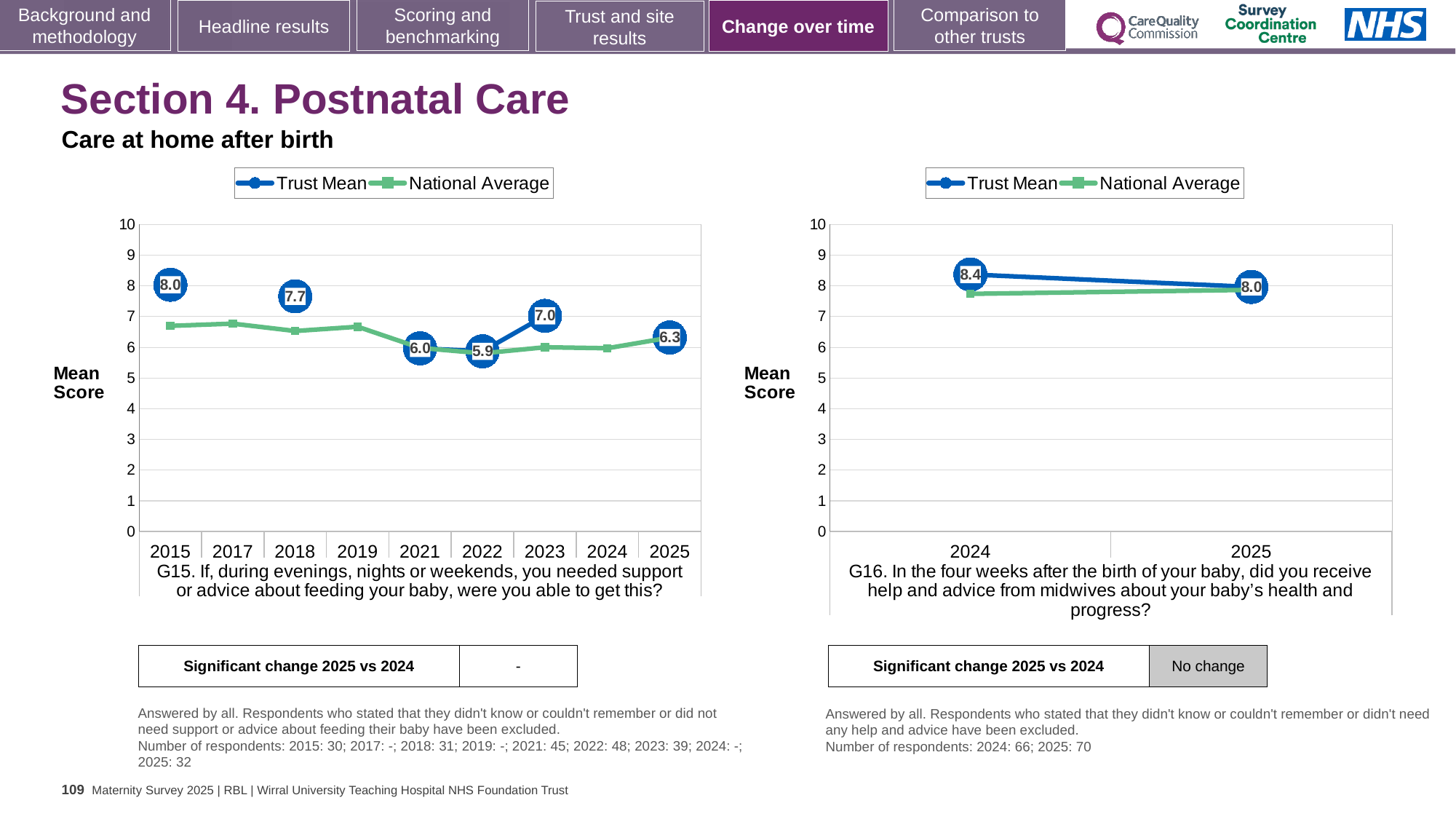
On the left chart (G15), what is the Trust Mean score for 2025? 6.3 On the left chart (G15), is the National Average for 2015 greater or less than 6? greater On the right chart (G16), what is the difference between the Trust Mean scores for 2024 and 2025? 0.4 What kind of chart is the left chart (G15)? Line chart On the left chart (G15), what is the Trust Mean score for 2015? 8.0 On the right chart (G16), what is the Trust Mean score for 2024? 8.4 On the left chart (G15), what is the Trust Mean score for 2023? 7.0 On the left chart (G15), in which year is the Trust Mean score highest? 2015 On the left chart (G15), is the Trust Mean score for 2018 greater or less than the Trust Mean score for 2021? greater On the left chart (G15), what is the difference between the Trust Mean scores for 2015 and 2025? 1.7 On the left chart (G15), in which year is the Trust Mean score lowest? 2022 On the right chart (G16), how many series does the legend list? 2